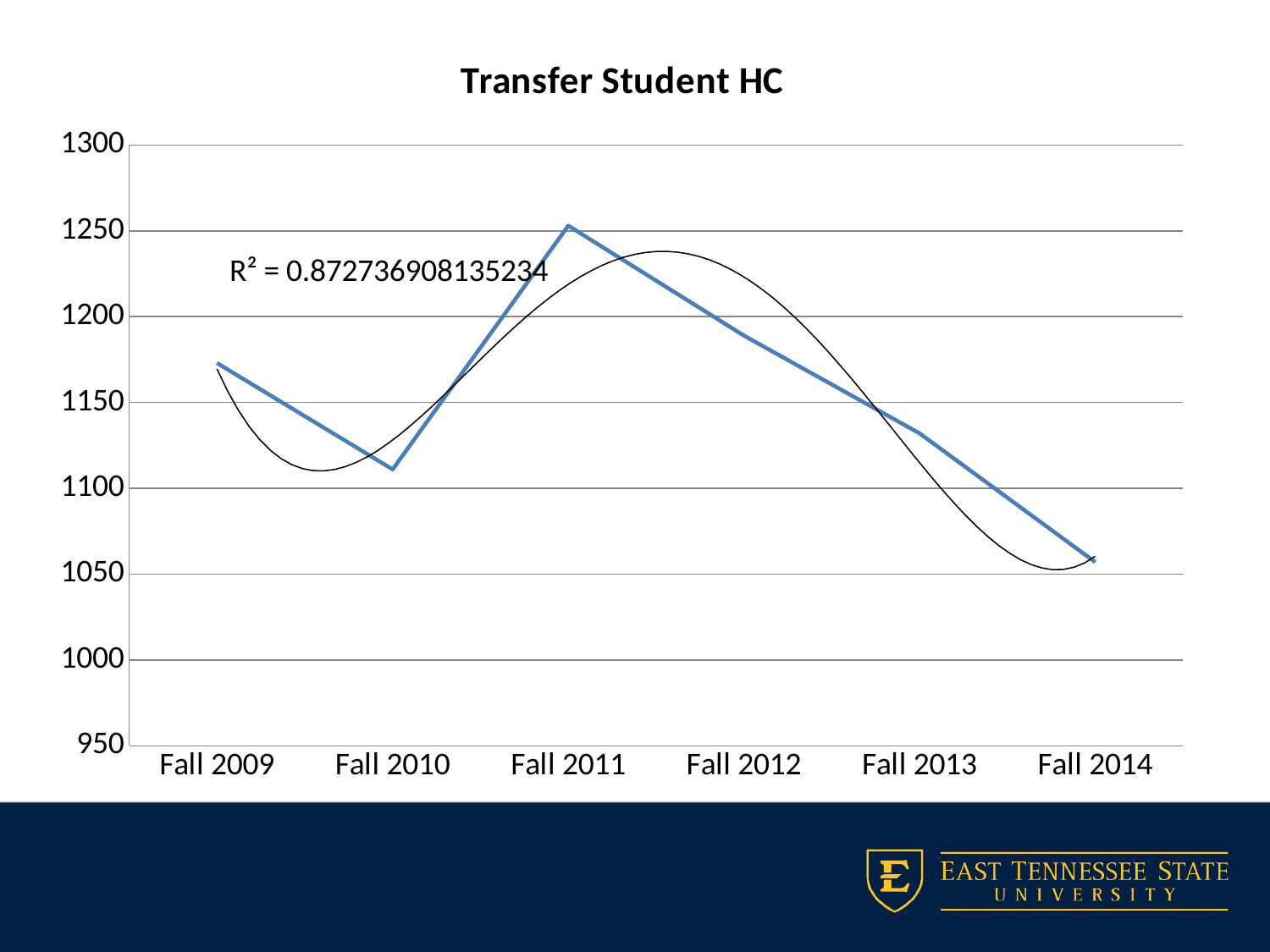
Which term has the lowest transfer student headcount? Fall 2014 Is the value for Fall 2009 greater or less than 1150? greater What is the title of the chart? Transfer Student HC Do the values rise or fall from Fall 2011 to Fall 2014? fall Is the value for Fall 2010 greater or less than 1150? less What R² value is printed on the chart? R² = 0.872736908135234 Which term has the highest transfer student headcount? Fall 2011 Is the value for Fall 2011 greater or less than 1200? greater Which is larger, the value for Fall 2009 or the value for Fall 2010? Fall 2009 How many time points are plotted along the x axis? 6 What kind of chart is shown on the slide? line chart